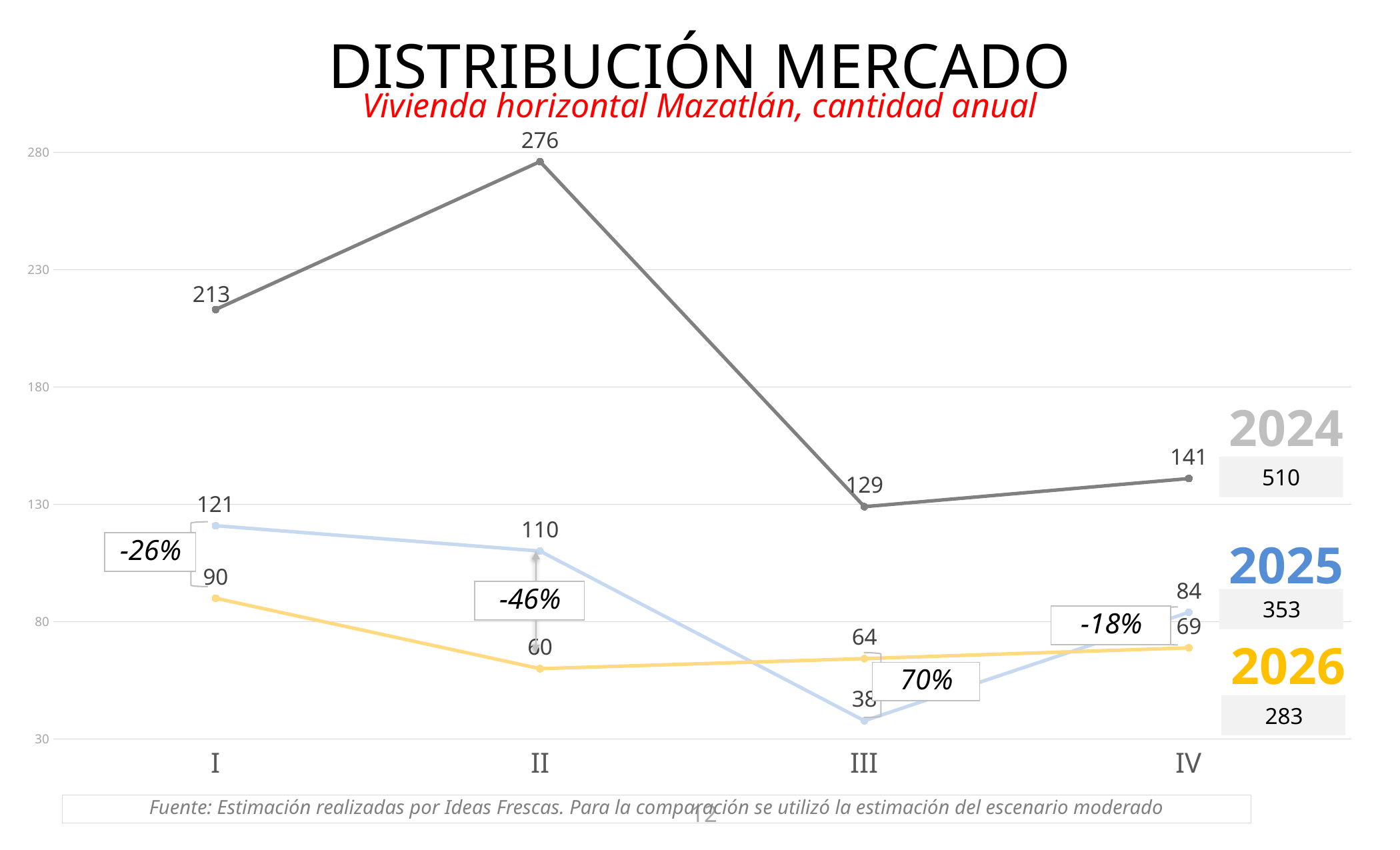
What is the difference between the 2024 and 2025 values in quarter I? 92 What is the value for 2024 in quarter II? 276 In which quarter does the 2025 series reach its lowest value? III What is the value for 2026 in quarter I? 90 What annual total is shown for 2025? 353 Which is larger in quarter IV, the 2025 value or the 2026 value? 2025 Is the value for 2024 in quarter III greater or less than 180? less What is the value for 2025 in quarter III? 38 In which quarter does the 2024 series reach its highest value? II What kind of chart is shown on the slide? line chart How many series (years) are plotted on the chart? 3 How many quarters are shown on the x axis? 4